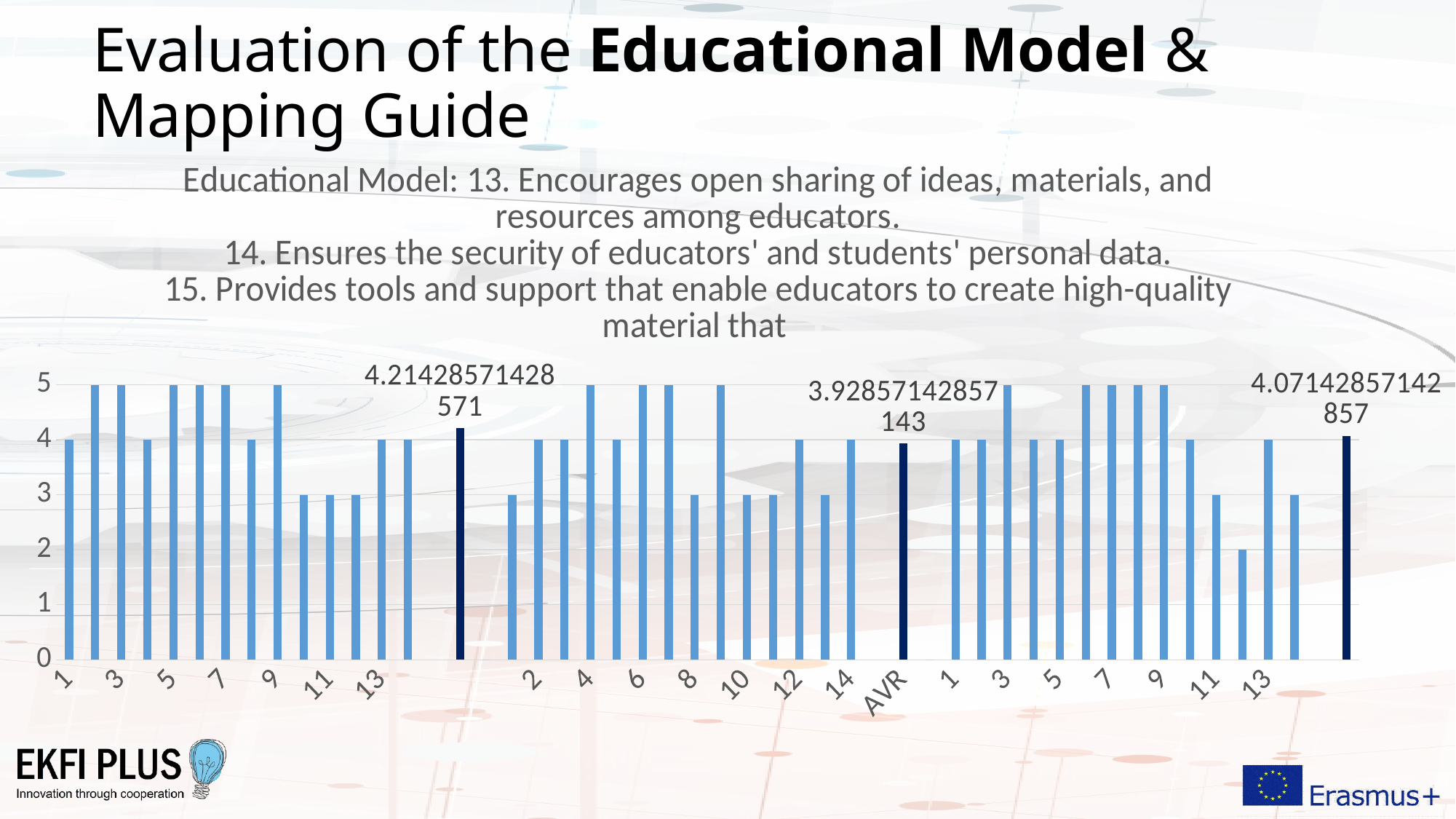
What is the lowest individual rating shown by any bar in the chart? 2 In the second group of bars, what is the value for respondent 8? 3 In the first group of bars, what is the value for respondent 1? 4 Which of the three AVR bars has the highest value? the first (leftmost) one, 4.21428571428571 In the first group of bars, what is the value for respondent 11? 3 What kind of chart is shown on the slide? bar chart What is the value printed on the middle AVR bar (labelled AVR on the axis)? 3.92857142857143 Is the value of the middle AVR bar greater or less than 4? less What is the highest value shown on the vertical axis? 5 What is the value printed on the rightmost AVR bar? 4.07142857142857 Which of the three AVR bars has the lowest value? the middle one, 3.92857142857143 What is the value printed on the first (leftmost) AVR bar? 4.21428571428571